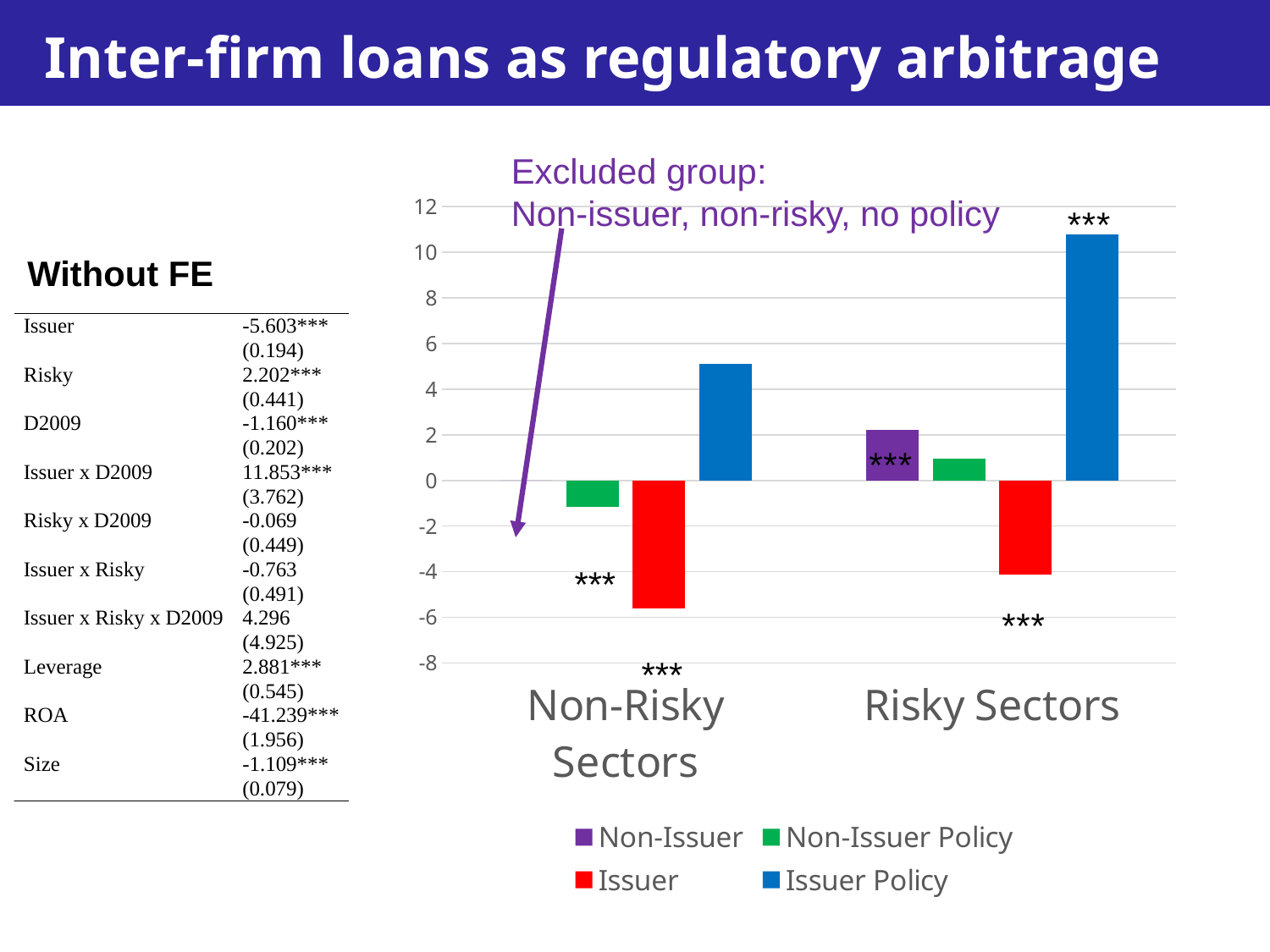
Which series and sector has the lowest bar in the chart? Issuer in Non-Risky Sectors What kind of chart is shown on the slide? bar chart How many series does the chart's legend list? 4 Which series and sector has the highest bar in the chart? Issuer Policy in Risky Sectors Which sector has the larger Issuer Policy value, Non-Risky Sectors or Risky Sectors? Risky Sectors How many sector categories are shown on the x axis of the chart? 2 Is the Issuer Policy value for Non-Risky Sectors greater or less than 4? greater Is the Issuer value for Risky Sectors greater or less than -2? less Is the Issuer value for Non-Risky Sectors greater or less than -4? less Which colour represents the Issuer series in the chart's legend? red According to the annotation on the chart, what is the excluded group? Non-issuer, non-risky, no policy